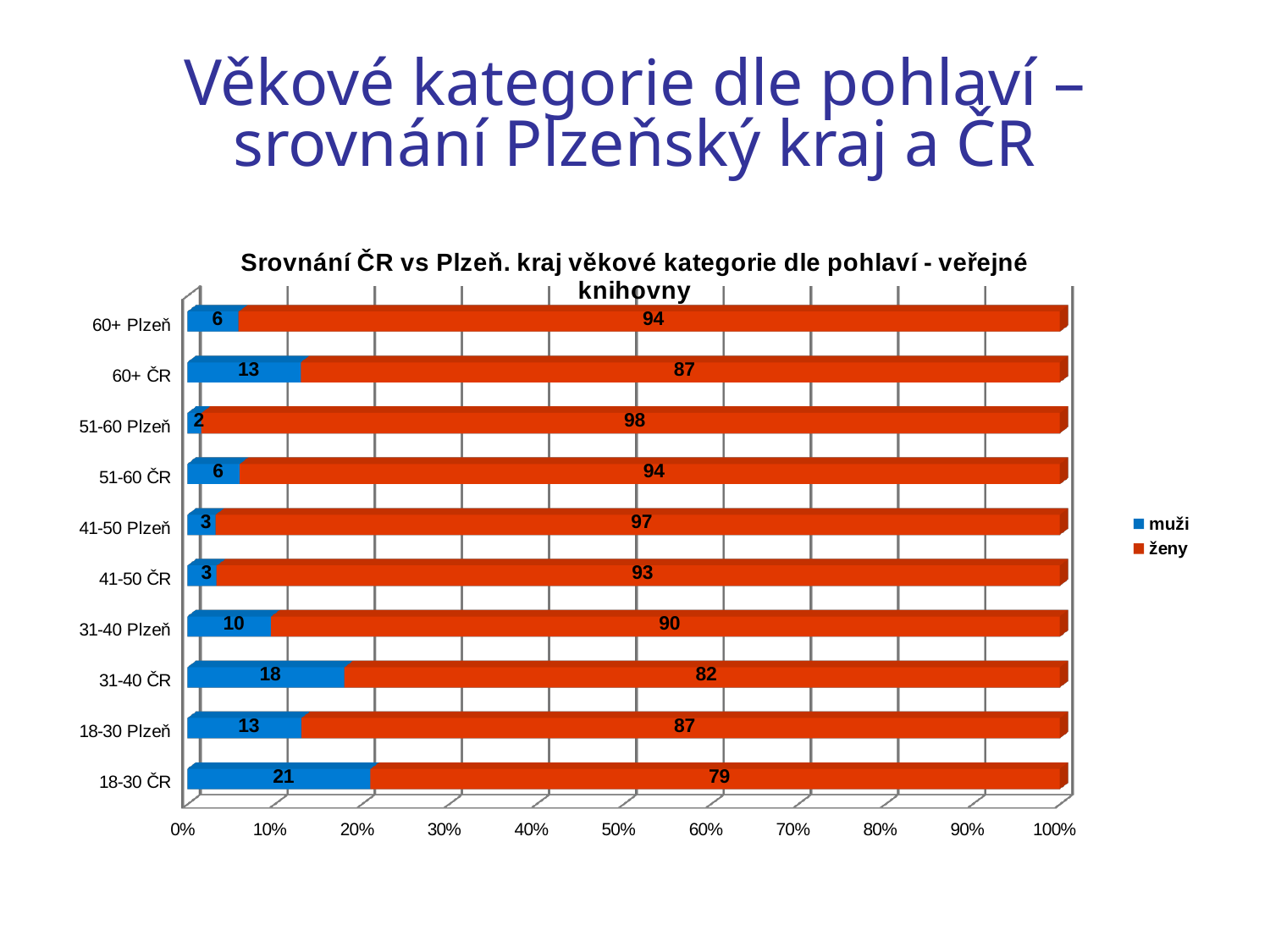
What is the value for muži in the 31-40 ČR category? 18 How many series does the legend list? 2 Which is larger, the muži value for 60+ ČR or for 60+ Plzeň? 60+ ČR Which category has the highest value for muži? 18-30 ČR Which category has the lowest value for muži? 51-60 Plzeň What kind of chart is shown on the slide? Stacked bar chart What is the value for muži in the 18-30 ČR category? 21 Which series is shown in blue in the legend? muži What is the difference between the muži values for 18-30 ČR and 18-30 Plzeň? 8 What is the value for ženy in the 51-60 Plzeň category? 98 What is the value for ženy in the 60+ ČR category? 87 How many categories are shown on the vertical axis? 10